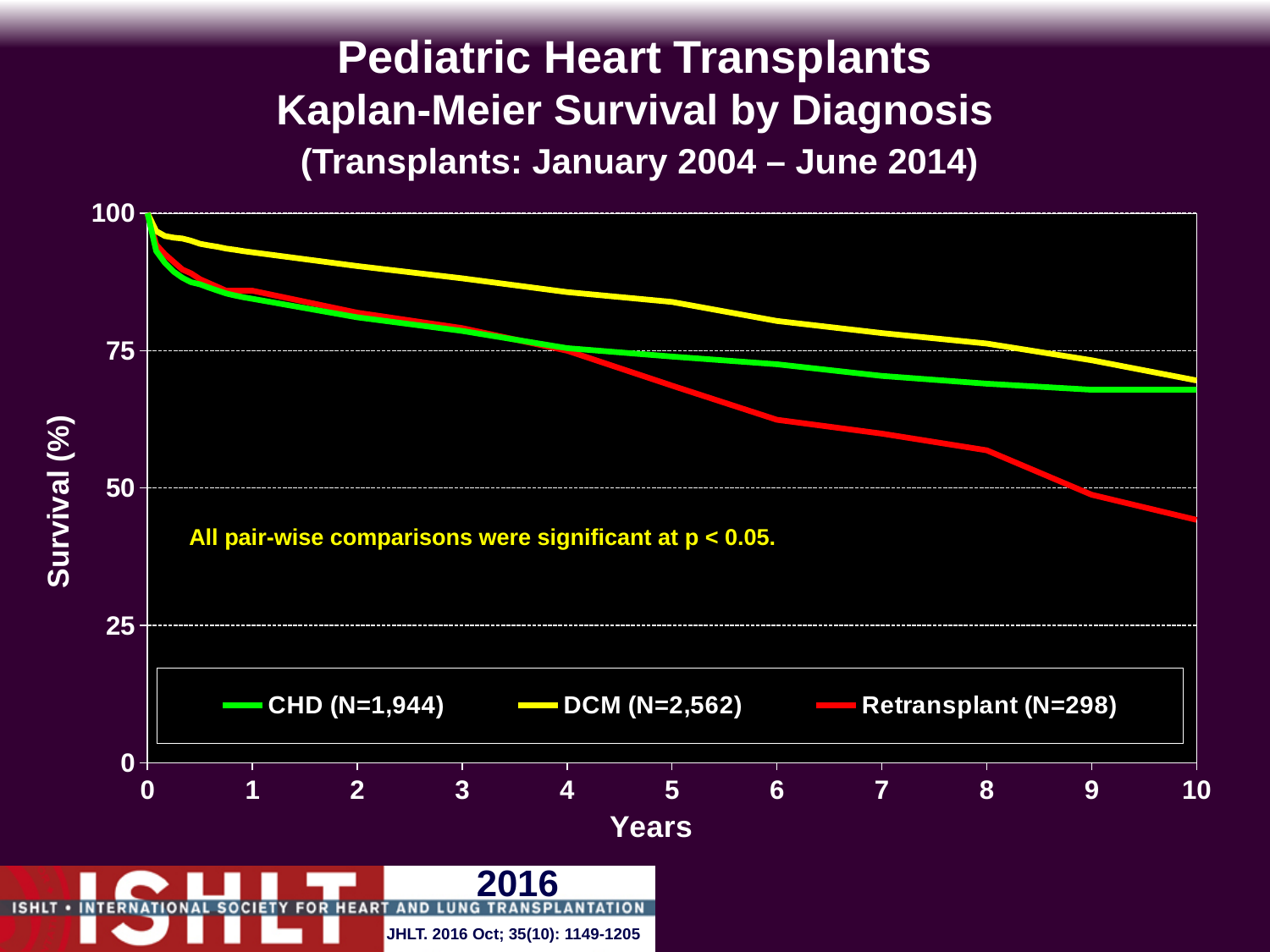
Is the survival for CHD at 10 years greater or less than 50%? greater Is the survival for Retransplant at 8 years greater or less than 50%? greater What is the N for the DCM group shown in the legend? N=2,562 Is the survival for DCM at 5 years greater or less than 75%? greater Which diagnosis group has the highest survival at 10 years? DCM What kind of chart is shown on the slide? line chart Do the survival curves rise or fall as years increase? fall What is the label of the y axis? Survival (%) At 7 years, which group has higher survival, DCM or Retransplant? DCM Which diagnosis group has the lowest survival at 10 years? Retransplant How many series does the legend list? 3